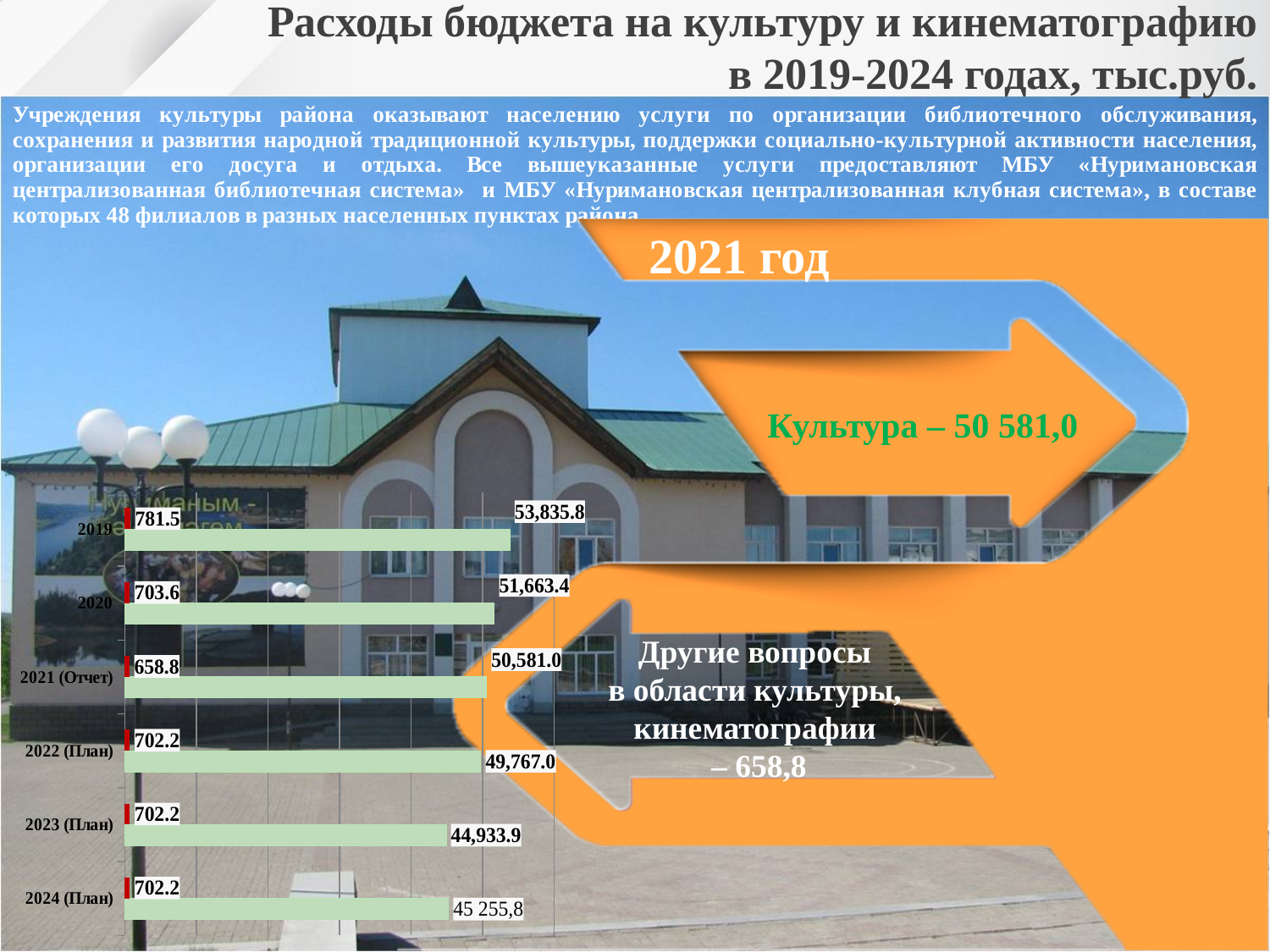
Which is larger, the green bar value for 2022 (План) or for 2023 (План)? 2022 (План) What is the value of the red bar for 2021 (Отчет)? 658.8 Which year has the highest value for the green bar? 2019 How many categories (years) are shown on the chart? 6 Which year has the lowest value for the green bar? 2023 (План) What is the value of the green bar for 2021 (Отчет)? 50,581.0 According to the orange arrow, what was the amount for Культура in 2021? 50 581,0 What type of chart is shown on the slide? bar chart What is the value of the green bar for 2019? 53,835.8 What is the value of the green bar for 2024 (План)? 45 255,8 What is the value of the red bar for 2020? 703.6 What is the difference between the green bar values for 2019 and 2020? 2,172.4